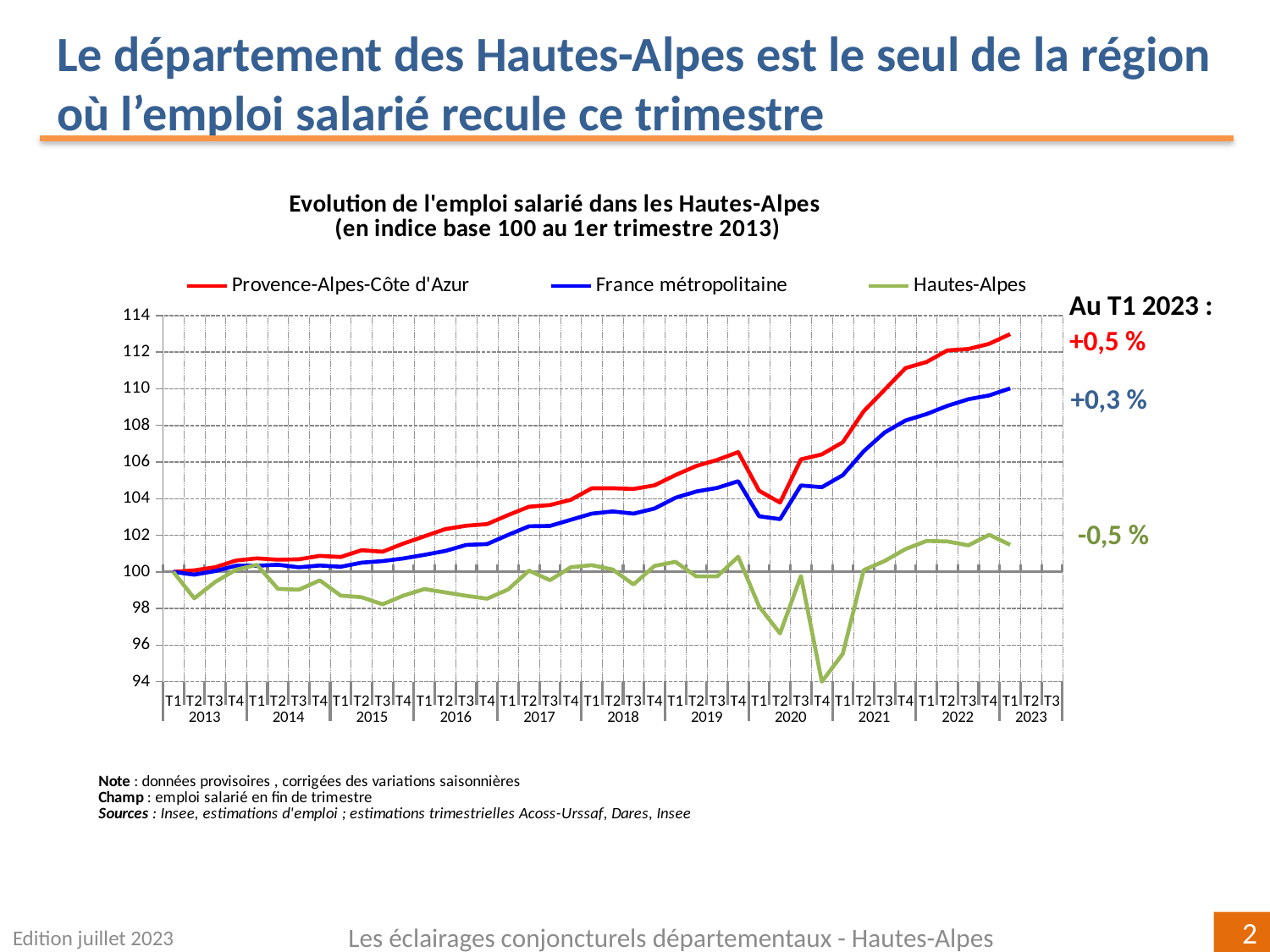
Does the Provence-Alpes-Côte d'Azur series generally rise or fall from 2013 to 2023? rise Which series has the highest index value at T1 2023? Provence-Alpes-Côte d'Azur What is the title of the chart? Evolution de l'emploi salarié dans les Hautes-Alpes (en indice base 100 au 1er trimestre 2013) What quarterly change is annotated for Provence-Alpes-Côte d'Azur at T1 2023? +0,5 % What quarterly change is annotated for France métropolitaine at T1 2023? +0,3 % How many series does the legend list? 3 Is the value for Hautes-Alpes at T4 2020 greater or less than 96? less Which series has the lowest index value at T1 2023? Hautes-Alpes Is the value for Provence-Alpes-Côte d'Azur at T1 2023 greater or less than 112? greater What quarterly change is annotated for Hautes-Alpes at T1 2023? -0,5 % What kind of chart is shown on the slide? line chart Which colour is used for the Hautes-Alpes series? green